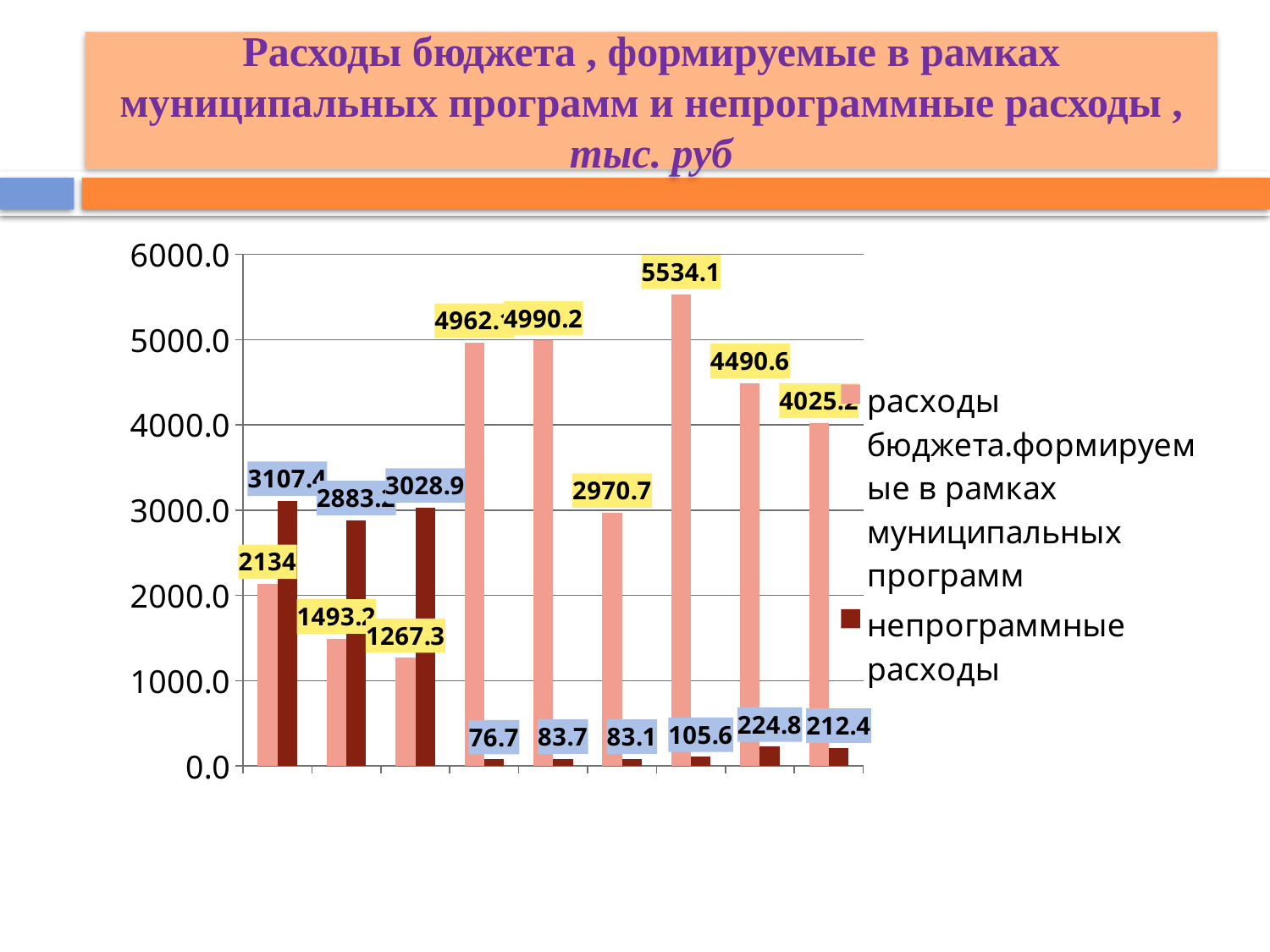
How many groups of bars are plotted along the x axis? 9 What is the difference between the highest and lowest values of the series 'расходы бюджета, формируемые в рамках муниципальных программ'? 4266.8 Is the highest value of the series 'расходы бюджета, формируемые в рамках муниципальных программ' greater or less than 5000? greater How many series does the legend list? 2 What is the lowest value in the series 'непрограммные расходы'? 76.7 What is the highest value in the series 'расходы бюджета, формируемые в рамках муниципальных программ'? 5534.1 What kind of chart is shown on the slide? bar chart What unit of measurement is stated in the chart title? тыс. руб What is the lowest value in the series 'расходы бюджета, формируемые в рамках муниципальных программ'? 1267.3 In the rightmost group of bars, which series has the larger value: 'расходы бюджета, формируемые в рамках муниципальных программ' or 'непрограммные расходы'? расходы бюджета, формируемые в рамках муниципальных программ In the leftmost group of bars, which series has the larger value: 'расходы бюджета, формируемые в рамках муниципальных программ' or 'непрограммные расходы'? непрограммные расходы What colour are the bars for the series 'непрограммные расходы'? dark red